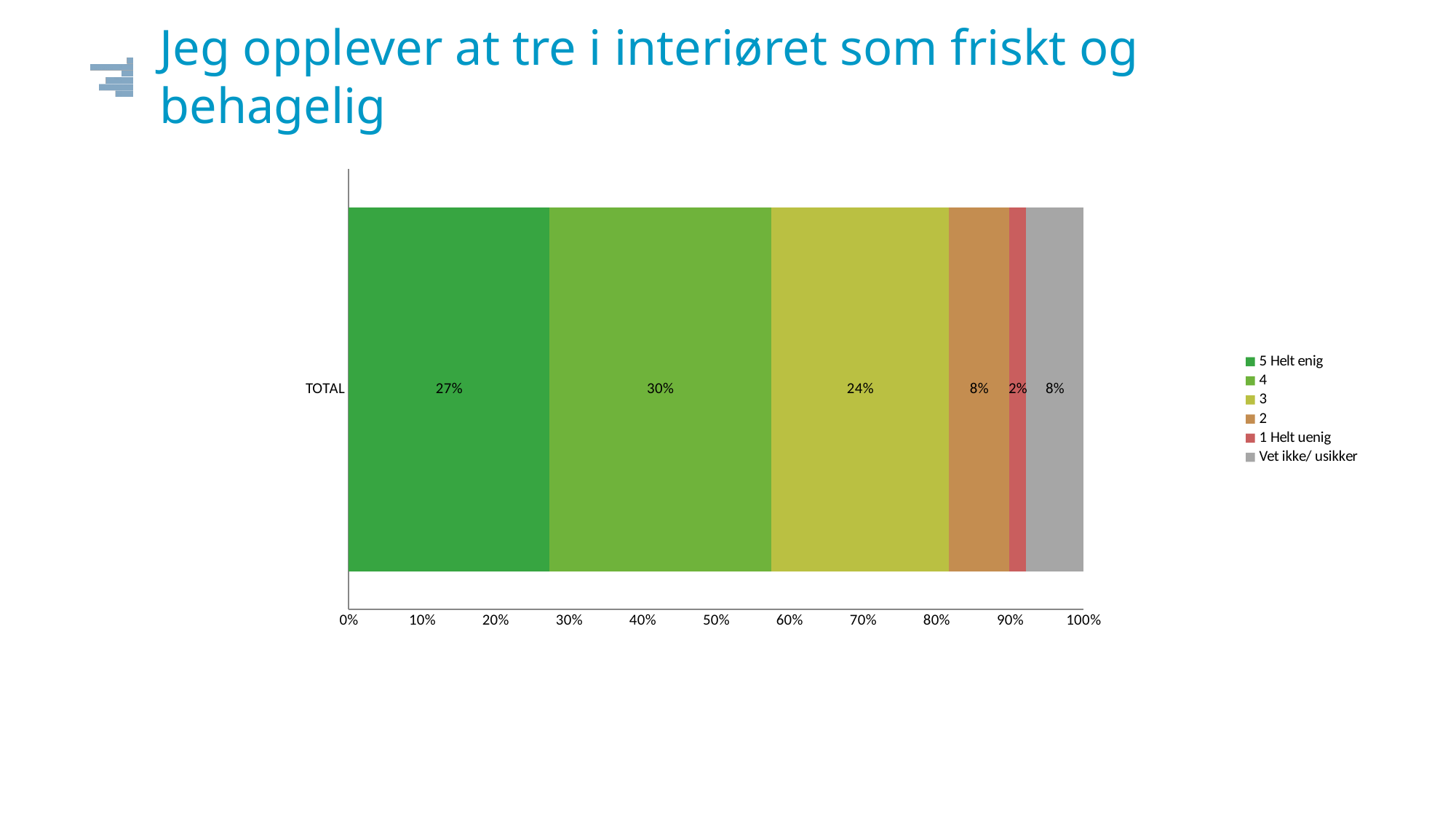
What is the label of the single category on the vertical axis? TOTAL What percentage of respondents answered "3"? 24% What kind of chart is shown on the slide? Stacked bar chart What percentage of respondents answered "4"? 30% Which is larger, the share for "3" or the share for "2"? 3 How many series does the legend list? 6 Which response category has the smallest share? 1 Helt uenig What percentage of respondents answered "5 Helt enig"? 27% What percentage of respondents answered "Vet ikke/ usikker"? 8% What is the difference between the share for "4" and the share for "5 Helt enig"? 3% Which response category has the largest share? 4 What percentage of respondents answered "1 Helt uenig"? 2%